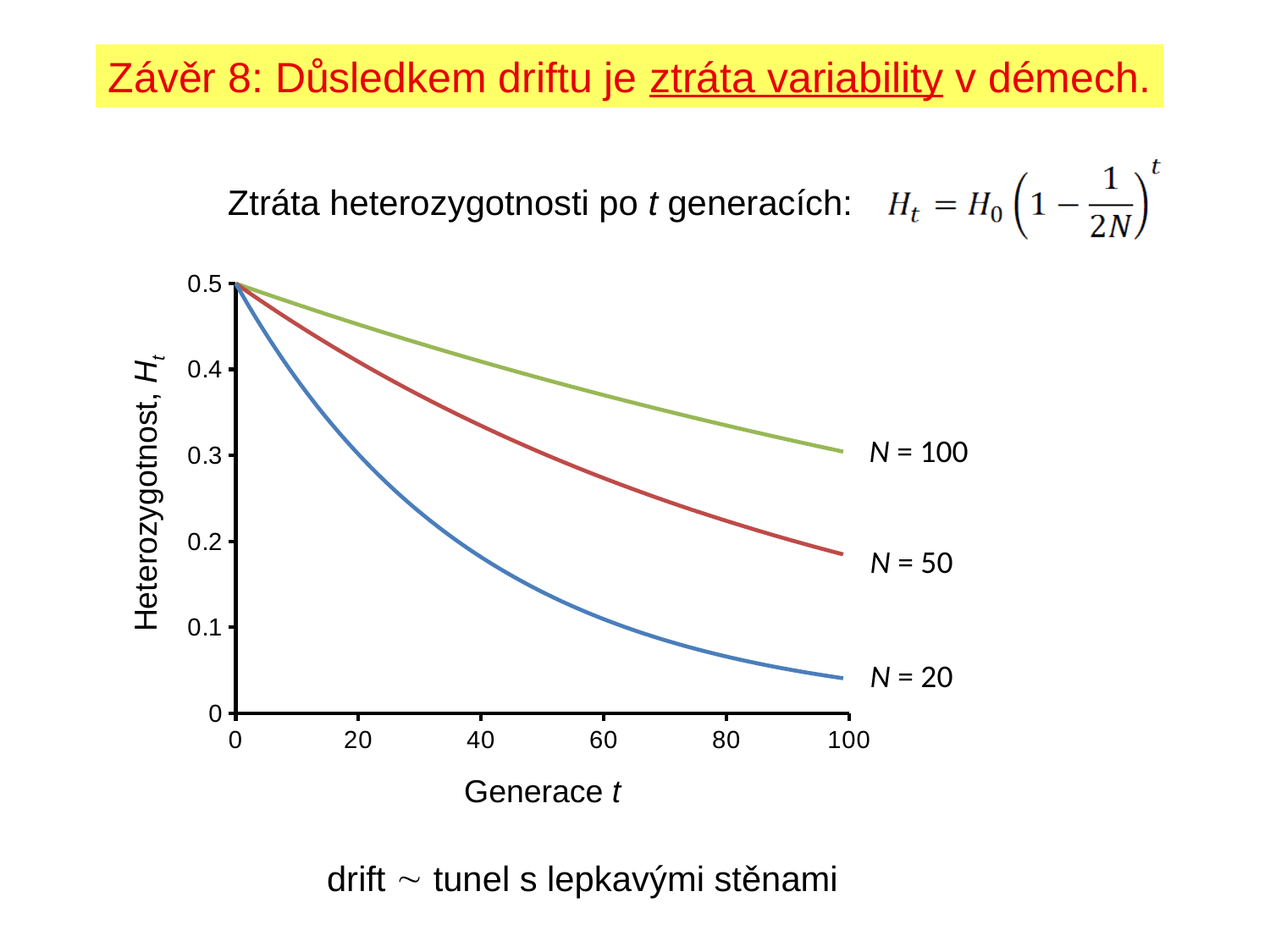
What is the label of the x axis? Generace t How many curves (series) are plotted on the chart? 3 Which series labels are shown next to the curves? N = 100, N = 50, N = 20 Do the heterozygosity values rise or fall as generation t increases? fall What kind of chart is shown on the slide? line chart Which curve has the lowest heterozygosity at generation 100? N = 20 At generation 60, which is larger: the heterozygosity for N = 50 or for N = 20? N = 50 At generation 100, is the heterozygosity for N = 50 greater or less than 0.2? less At generation 100, is the heterozygosity for N = 20 greater or less than 0.1? less Which curve has the highest heterozygosity at generation 100? N = 100 What is the heterozygosity value of all three curves at generation 0? 0.5